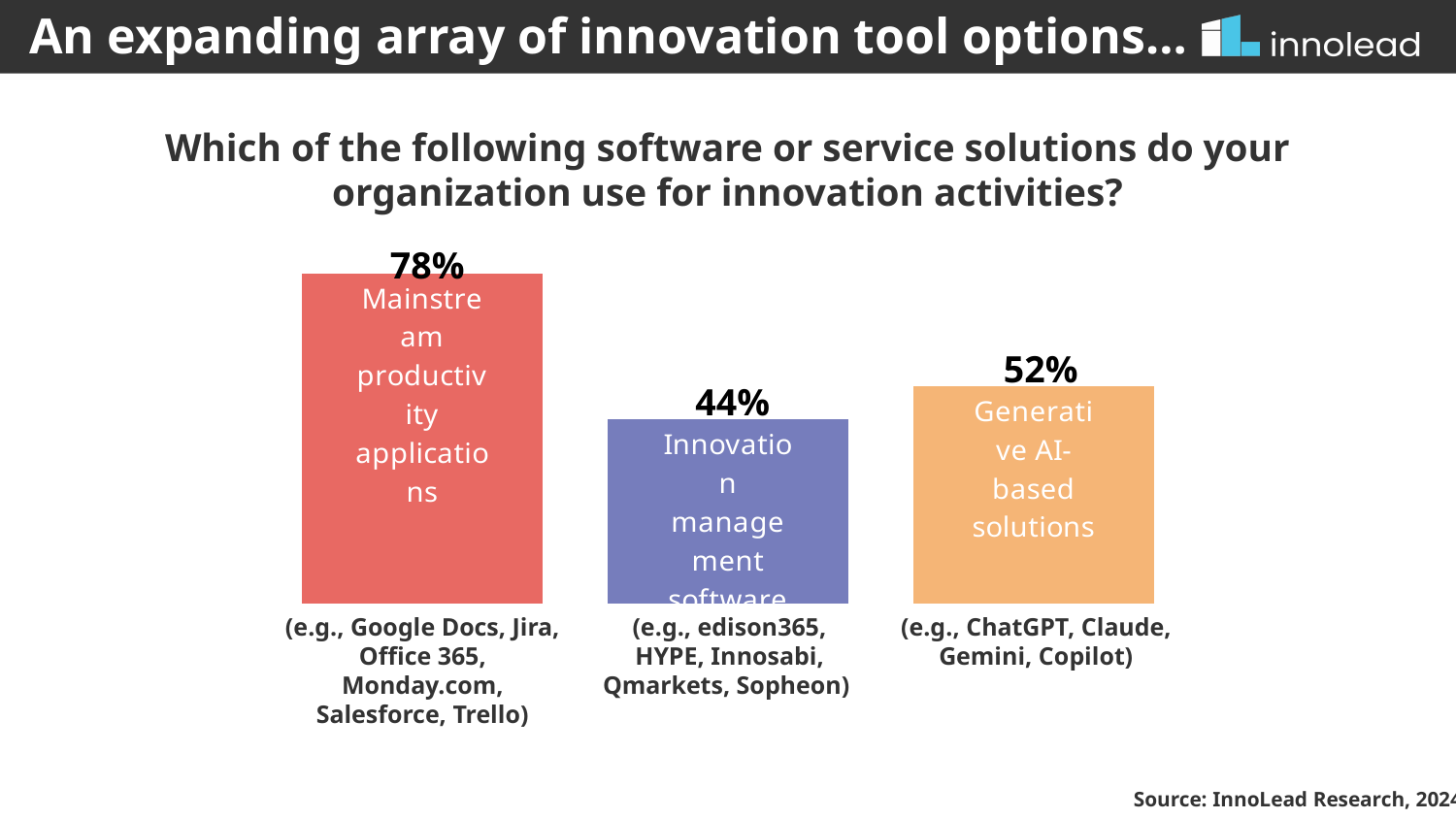
What is the difference in percentage points between generative AI-based solutions and innovation management software? 8 What percentage of organizations use mainstream productivity applications for innovation activities? 78% How many categories are shown in the chart? 3 Which category has the highest percentage? Mainstream productivity applications Which is larger: the percentage for generative AI-based solutions or for innovation management software? Generative AI-based solutions What is the difference in percentage points between mainstream productivity applications and innovation management software? 34 What percentage of organizations use innovation management software? 44% What question does the chart answer, according to the heading above it? Which of the following software or service solutions do your organization use for innovation activities? What kind of chart is shown on the slide? Bar chart What percentage of organizations use generative AI-based solutions? 52% Which category has the lowest percentage? Innovation management software What colour is the bar for generative AI-based solutions? Orange